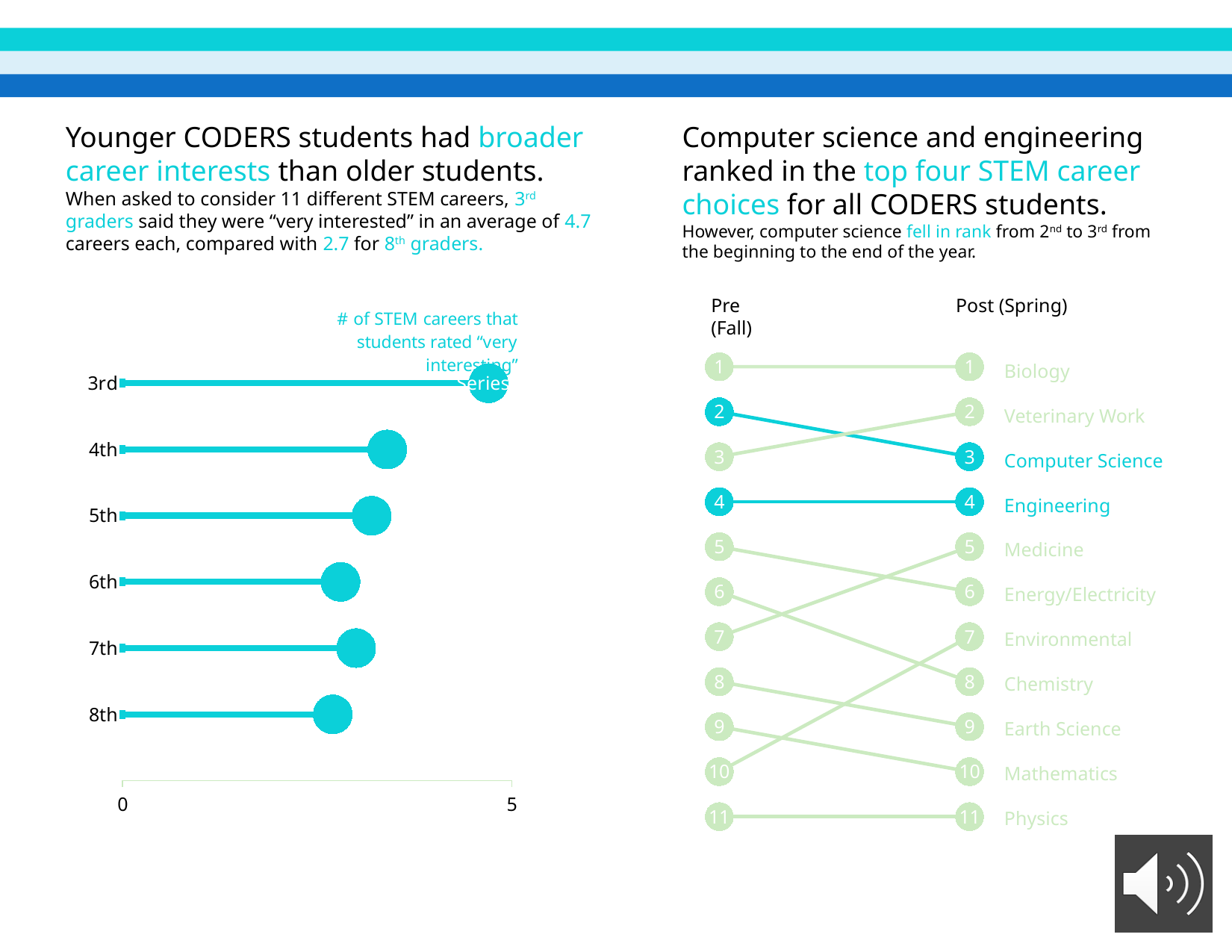
In the left chart, how many grade levels are plotted? 6 In the left chart, is the value for 3rd grade greater or less than 5? less In the right chart of STEM career rankings, how many STEM careers are ranked? 11 What kind of chart is the left chart, '# of STEM careers that students rated "very interesting"'? bar chart In the right chart of STEM career rankings, what are the two column headings? Pre (Fall) and Post (Spring) In the right chart of STEM career rankings, what rank did Computer Science hold in the Pre (Fall) column? 2 In the right chart of STEM career rankings, what rank did Computer Science hold in the Post (Spring) column? 3 In the left chart, what is the difference between the 3rd grade value and the 8th grade value? 2.0 In the left chart, which grade has the highest number of STEM careers rated 'very interesting'? 3rd In the left chart, which is larger, the value for 3rd grade or the value for 8th grade? 3rd grade In the left chart, what is the average number of STEM careers rated 'very interesting' by 8th graders? 2.7 In the left chart, what is the average number of STEM careers rated 'very interesting' by 3rd graders? 4.7